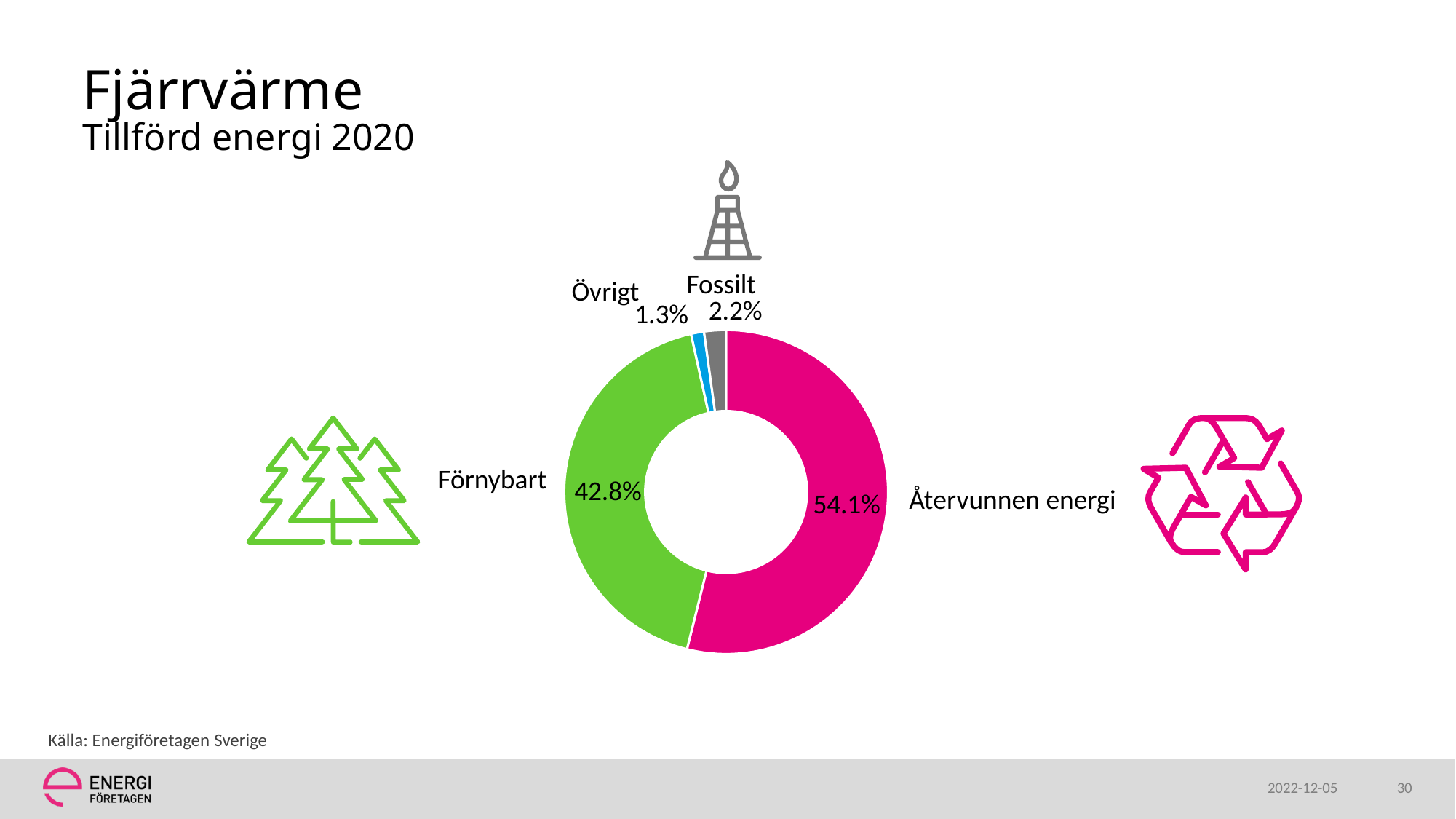
What kind of chart is shown on the slide? Doughnut chart What colour is the Förnybart slice? Green Which category has the smallest share of the chart? Övrigt What share of the chart does Övrigt have? 1.3% Which is larger, Fossilt or Övrigt? Fossilt What share of the chart does Förnybart have? 42.8% What is the difference in percentage points between Återvunnen energi and Förnybart? 11.3 What share of the chart does Återvunnen energi have? 54.1% What share of the chart does Fossilt have? 2.2% How many categories does the chart show? 4 What is the difference in percentage points between Fossilt and Övrigt? 0.9 Which category has the largest share of the chart? Återvunnen energi